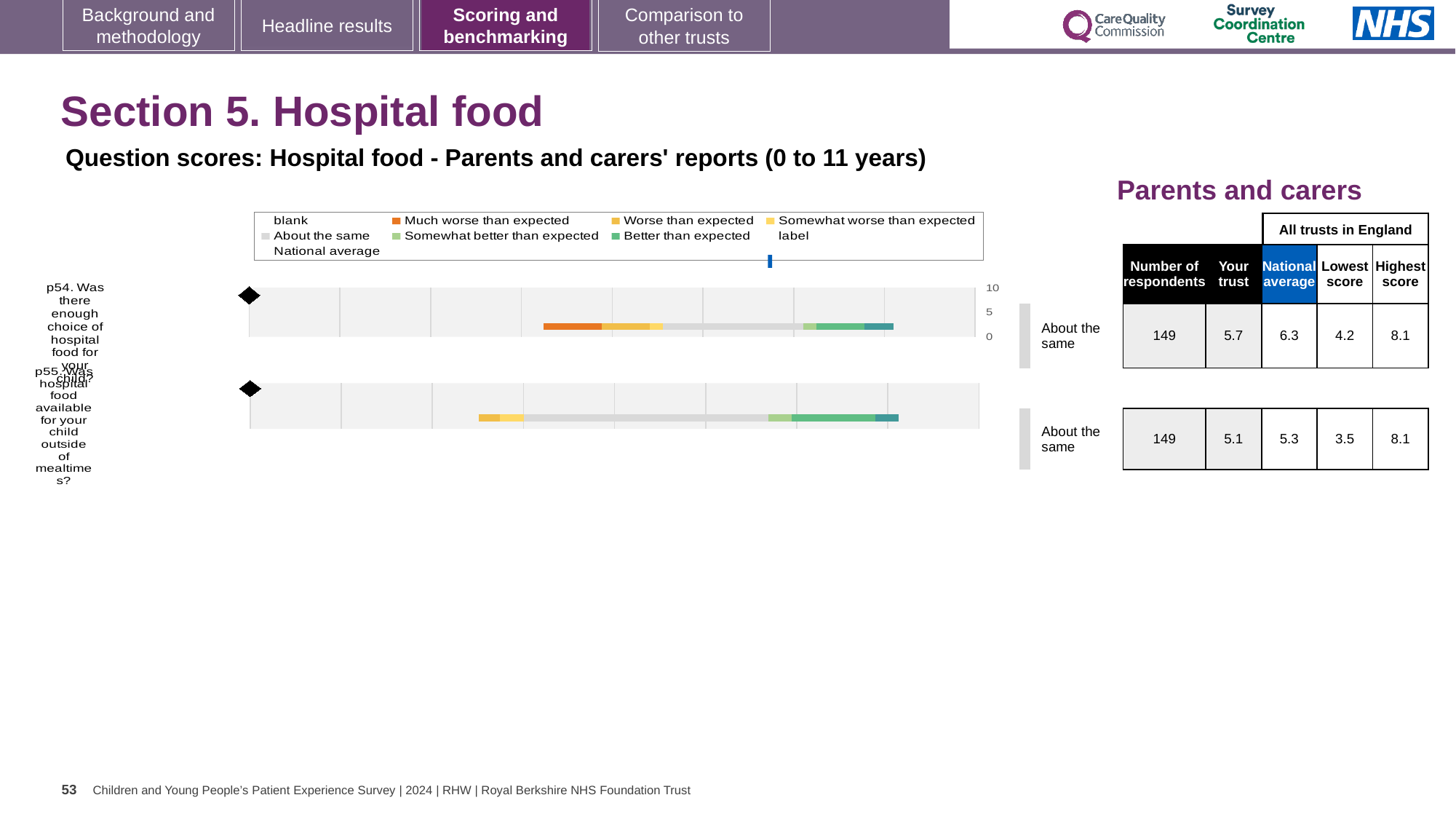
Which question has the higher 'Your trust' score, p54 or p55? p54 What is the lowest score among all trusts in England for p54? 4.2 How many entries does the chart legend list? 9 What is the national average score for p55 (hospital food available outside of mealtimes)? 5.3 What benchmark category is given for p55? About the same How many survey questions are plotted as bars in the chart? 2 By how much does the national average exceed the trust's score for p54? 0.6 How many respondents answered p54? 149 What is the 'Your trust' score for p54 (enough choice of hospital food)? 5.7 What is the highest score among all trusts in England for p55? 8.1 Which legend entry is shown in orange? Much worse than expected What kind of chart is shown on the slide? bar chart